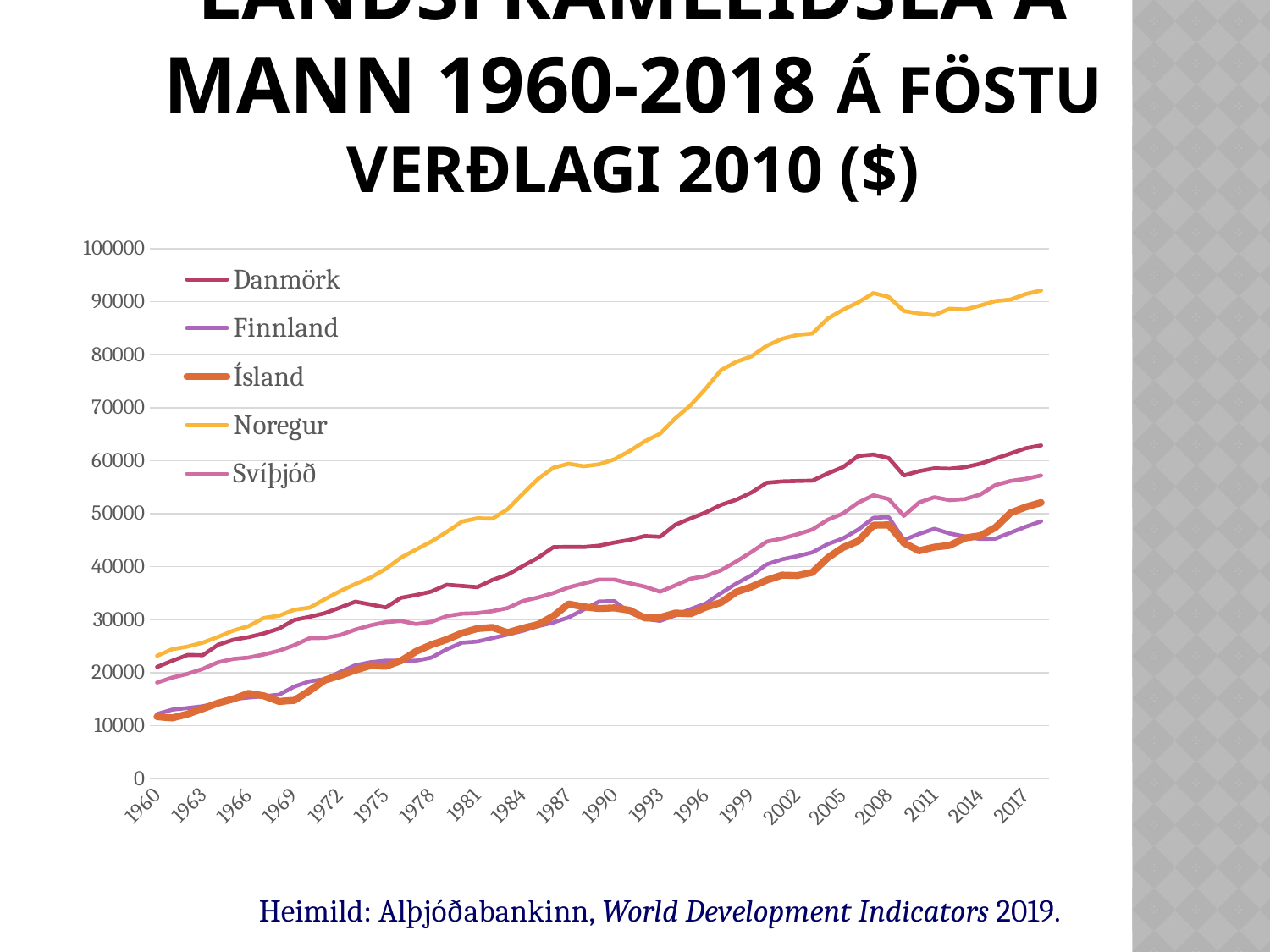
Is the value for Ísland in 1960 greater or less than 20000? less What kind of chart is shown on the slide? Line chart What colour is the line for Noregur in the legend? Yellow Is the value for Danmörk in 2018 greater or less than 60000? greater How many series does the legend list? 5 Which country has the highest value in 2018? Noregur What is the highest value shown on the vertical axis? 100000 Does the value for Noregur generally rise or fall from 1960 to 2018? Rise Which is larger in 2018, the value for Danmörk or the value for Svíþjóð? Danmörk Is the value for Ísland in 2010 greater or less than 50000? less Which country has the highest value throughout the period from 1960 to 2018? Noregur